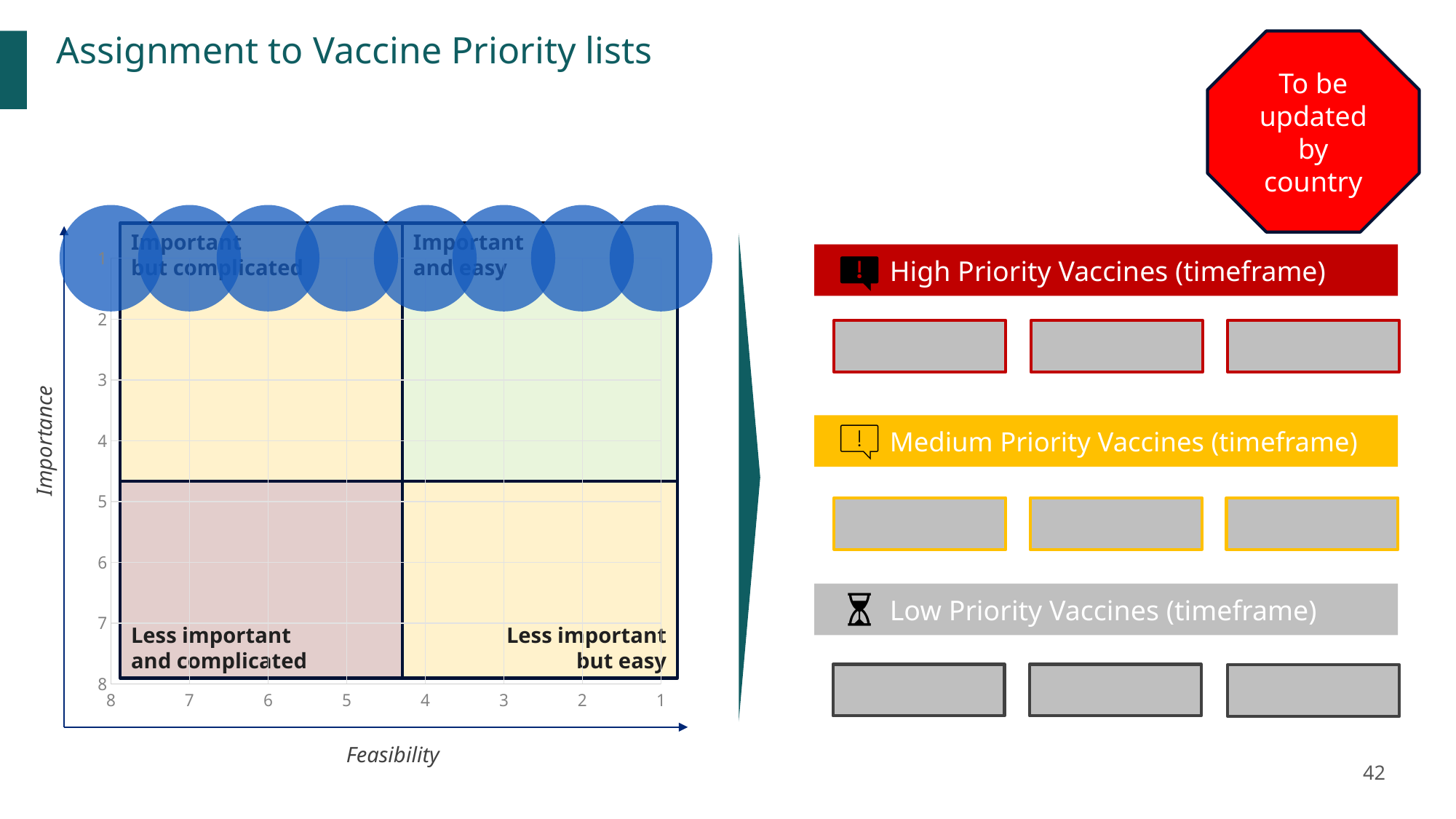
What is the label of the bottom-right quadrant of the chart? Less important but easy What is the label of the top-right quadrant of the chart? Important and easy What is the highest tick value shown on the Feasibility axis? 8 What is the label of the vertical axis of the chart? Importance What is the label of the horizontal axis of the chart? Feasibility Are the blue circles plotted at an Importance value greater or less than 4? less How many quadrants is the chart divided into? 4 What is the label of the top-left quadrant of the chart? Important but complicated How many blue circles are plotted on the chart? 8 What kind of chart is shown on the left of the slide? Bubble chart What is the label of the bottom-left quadrant of the chart? Less important and complicated